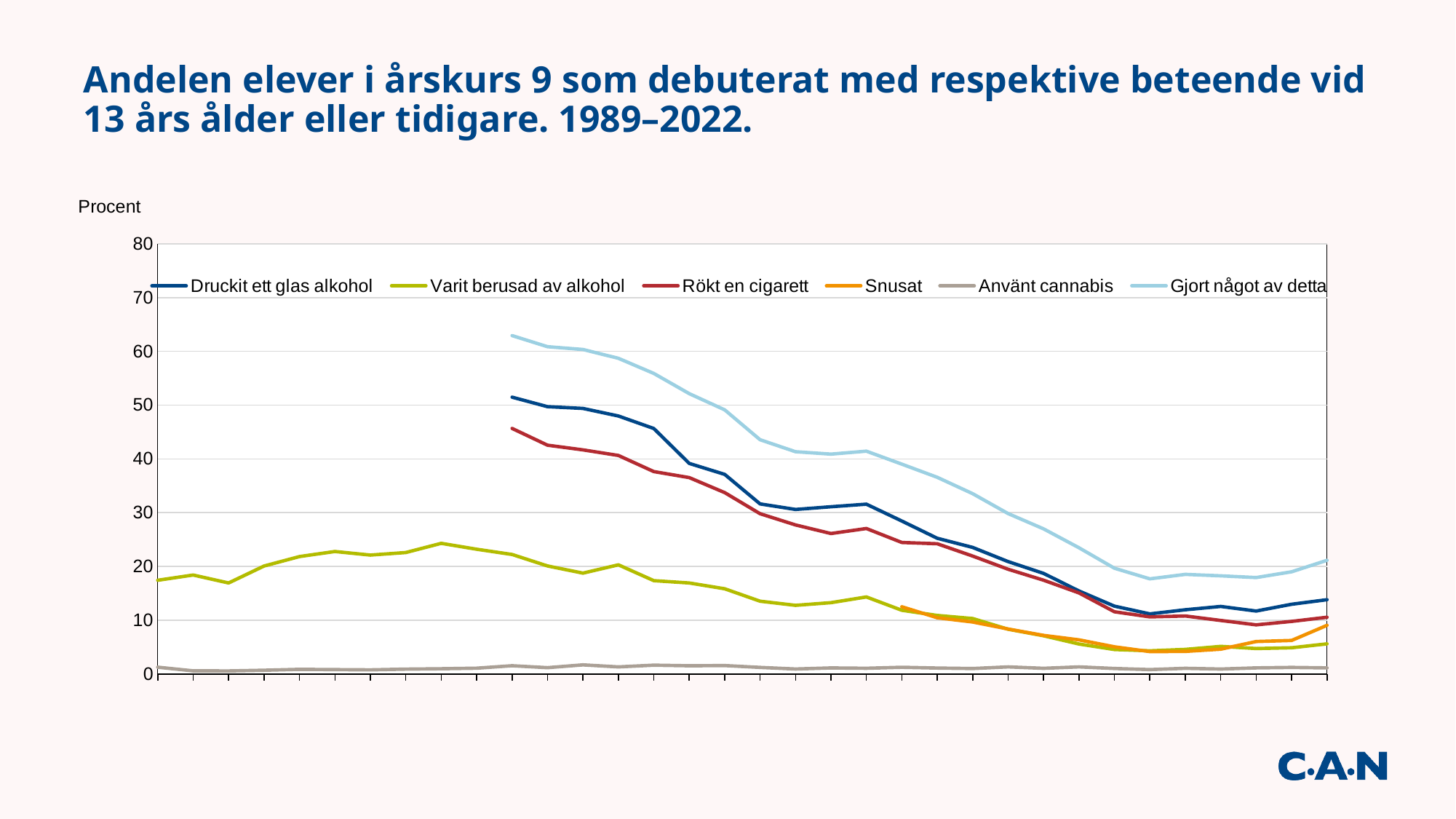
Is the highest value of 'Varit berusad av alkohol' greater or less than 30? less What label is shown on the vertical axis? Procent Does the 'Rökt en cigarett' series rise or fall overall from its first point to its last point? fall Does the 'Gjort något av detta' series rise or fall overall from its first point to its last point? fall What is the title of the chart? Andelen elever i årskurs 9 som debuterat med respektive beteende vid 13 års ålder eller tidigare. 1989–2022. Is the first plotted value of 'Gjort något av detta' greater or less than 60? greater Is the last plotted value of 'Gjort något av detta' greater or less than 30? less Which series has the lowest values throughout the chart? Använt cannabis At the last plotted point, which series is higher: 'Druckit ett glas alkohol' or 'Gjort något av detta'? Gjort något av detta Which series reaches the highest value anywhere on the chart? Gjort något av detta What kind of chart is shown on the slide? line chart How many series does the legend list? 6